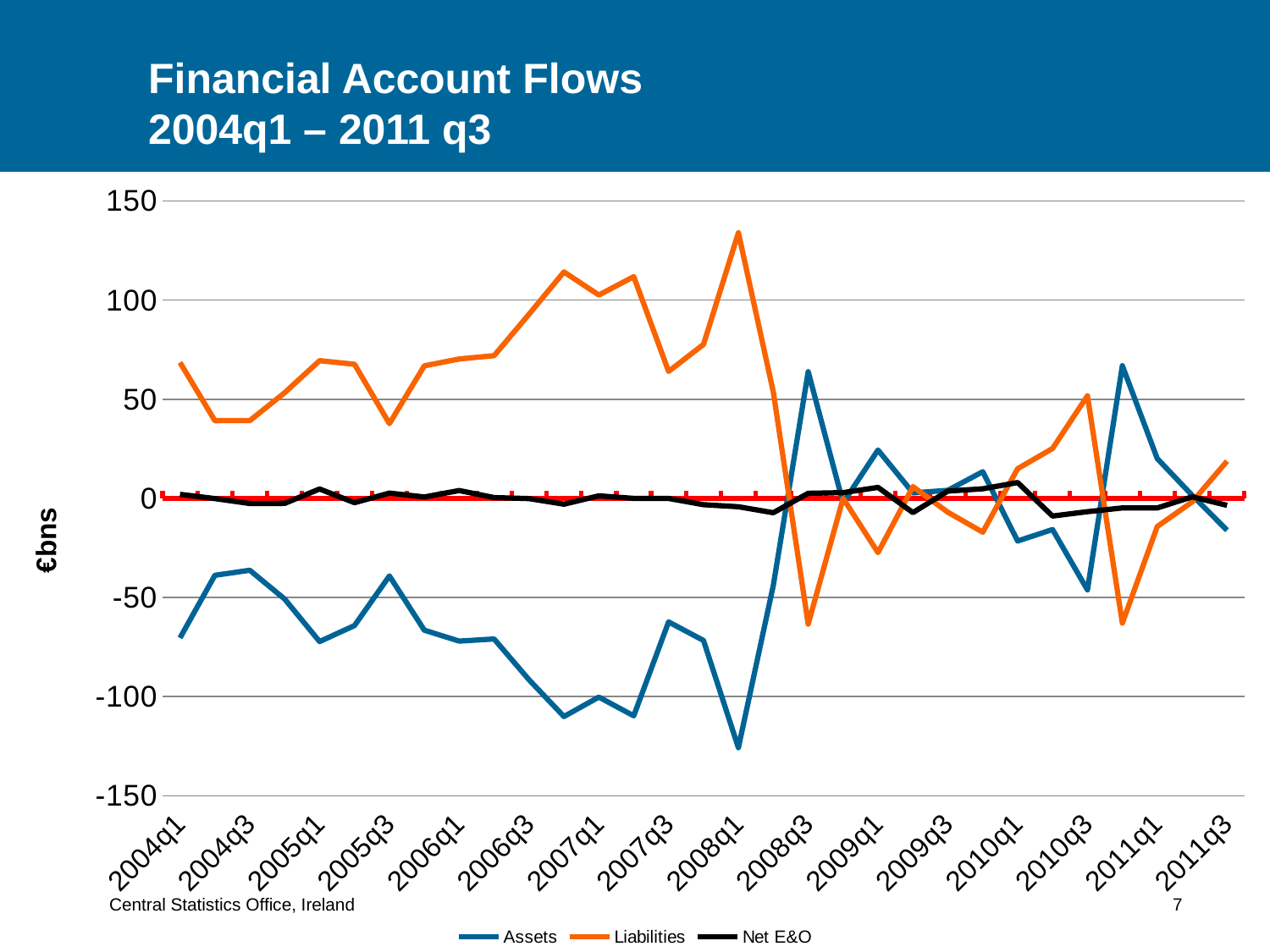
What are the three series named in the legend? Assets, Liabilities, Net E&O Is the value for Liabilities in 2008q1 greater or less than 100? greater Is the value for Assets in 2008q1 greater or less than -100? less In which quarter does the Liabilities series reach its highest value? 2008q1 In 2004q1, which series has the larger value, Assets or Liabilities? Liabilities Is the value for Liabilities in 2004q1 greater or less than 50? greater In which quarter does the Assets series reach its lowest value? 2008q1 How many series does the legend list? 3 What kind of chart is shown on the slide? Line chart How many quarter labels are shown along the x axis? 16 What is the label on the vertical axis? €bns